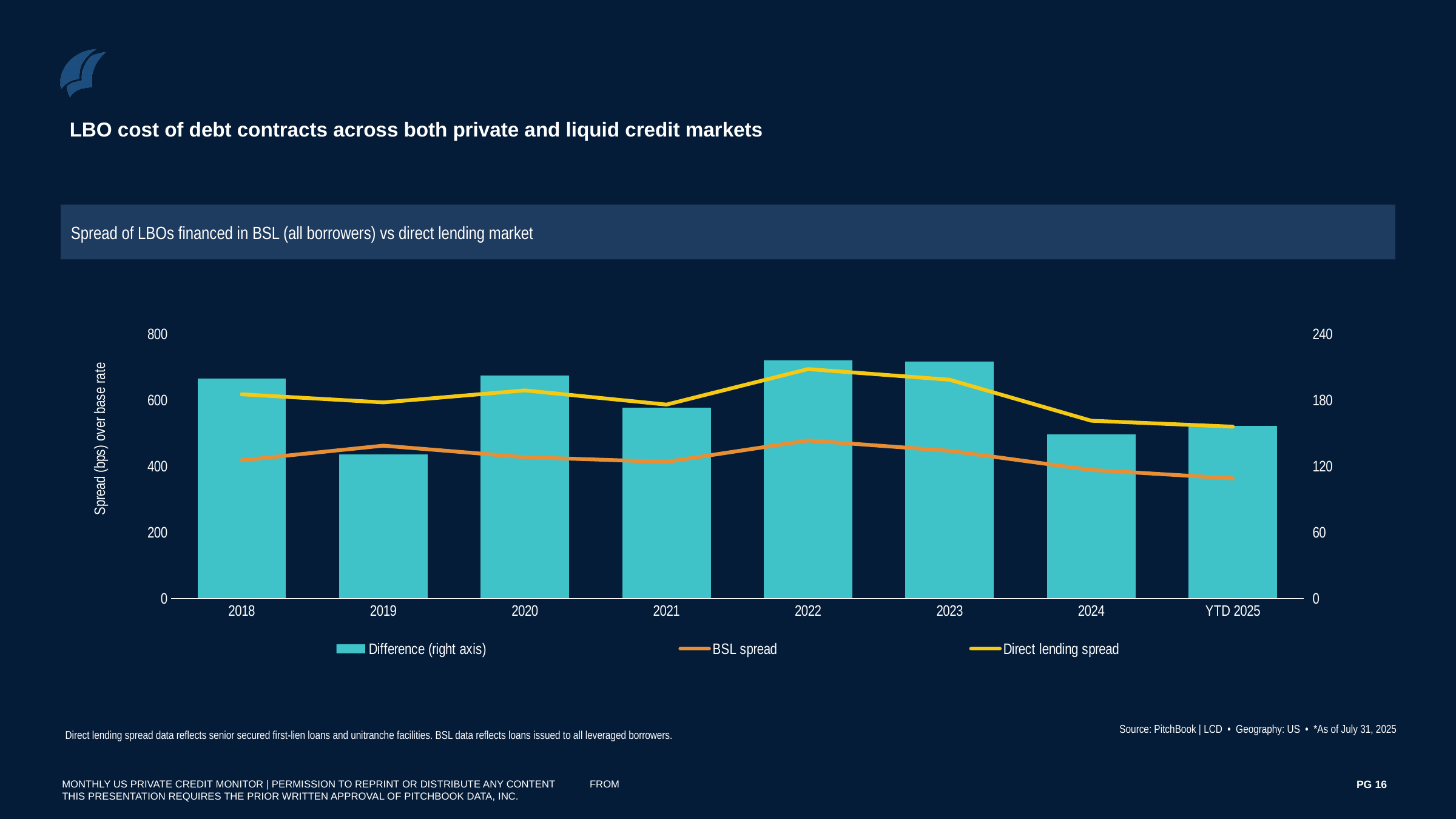
In which year does the Direct lending spread line reach its highest point? 2022 Is the Direct lending spread for 2022 greater or less than 600? greater Does the BSL spread rise or fall from 2022 to YTD 2025? Fall Which is larger in 2018, the Direct lending spread or the BSL spread? Direct lending spread Is the Difference (right axis) value for 2019 greater or less than 180? less In which period is the BSL spread at its lowest? YTD 2025 Which series is plotted as bars rather than a line? Difference (right axis) Which year has the lowest bar for Difference (right axis)? 2019 What kind of chart is shown on the slide? A combination bar and line chart How many time periods are shown on the x axis? 8 Is the BSL spread for YTD 2025 greater or less than 400? less How many series does the legend list? 3